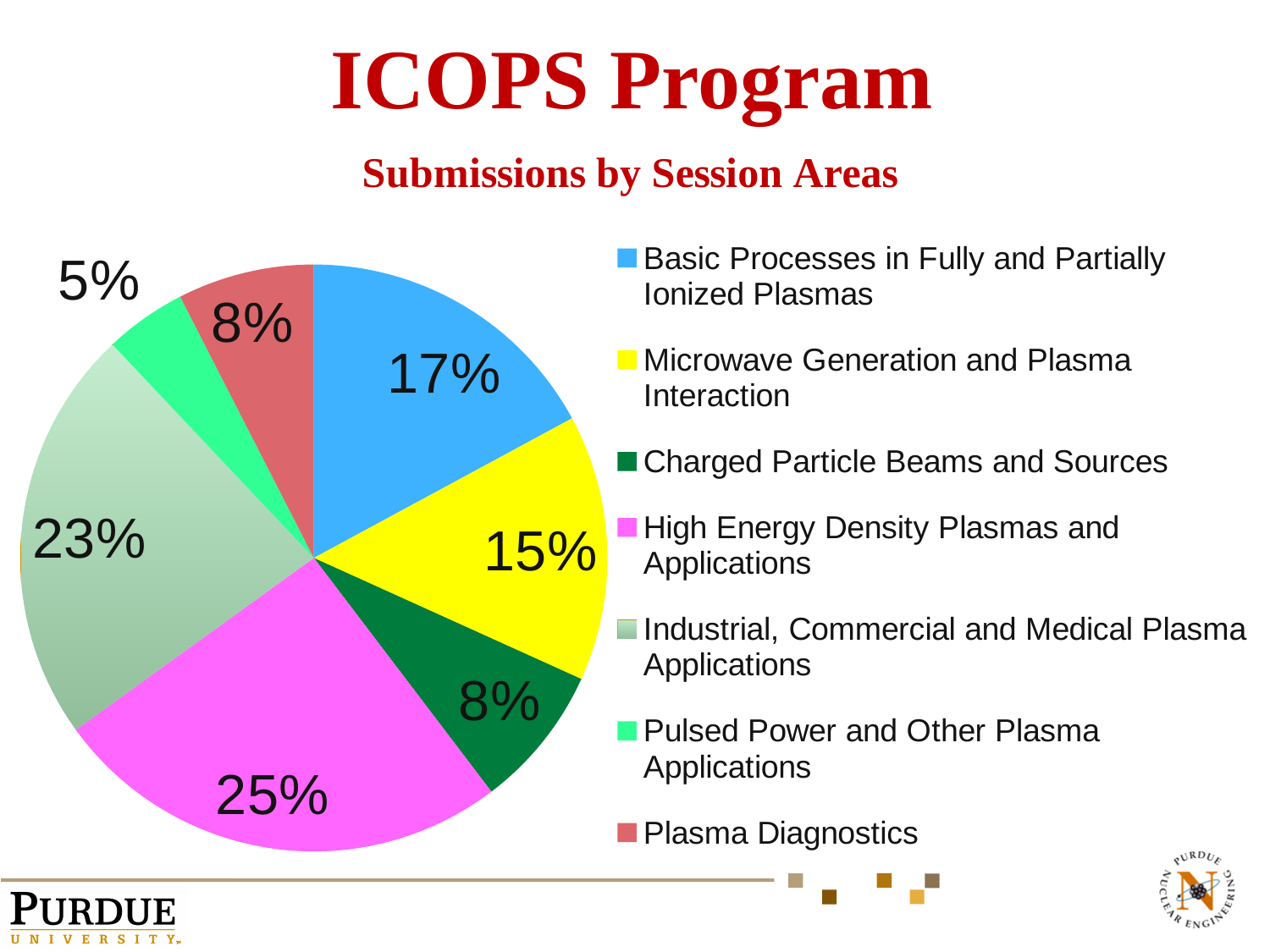
How many session areas does the legend list? 7 What share of submissions is for Microwave Generation and Plasma Interaction? 15% What share of submissions is for High Energy Density Plasmas and Applications? 25% What colour represents Plasma Diagnostics in the pie chart? red Which has a larger share: Basic Processes in Fully and Partially Ionized Plasmas or Microwave Generation and Plasma Interaction? Basic Processes in Fully and Partially Ionized Plasmas What share of submissions is for Industrial, Commercial and Medical Plasma Applications? 23% What is the difference in share between High Energy Density Plasmas and Applications and Industrial, Commercial and Medical Plasma Applications? 2% Which session area has the smallest share of submissions? Pulsed Power and Other Plasma Applications What kind of chart is shown on the slide? pie chart Which session area has the largest share of submissions? High Energy Density Plasmas and Applications